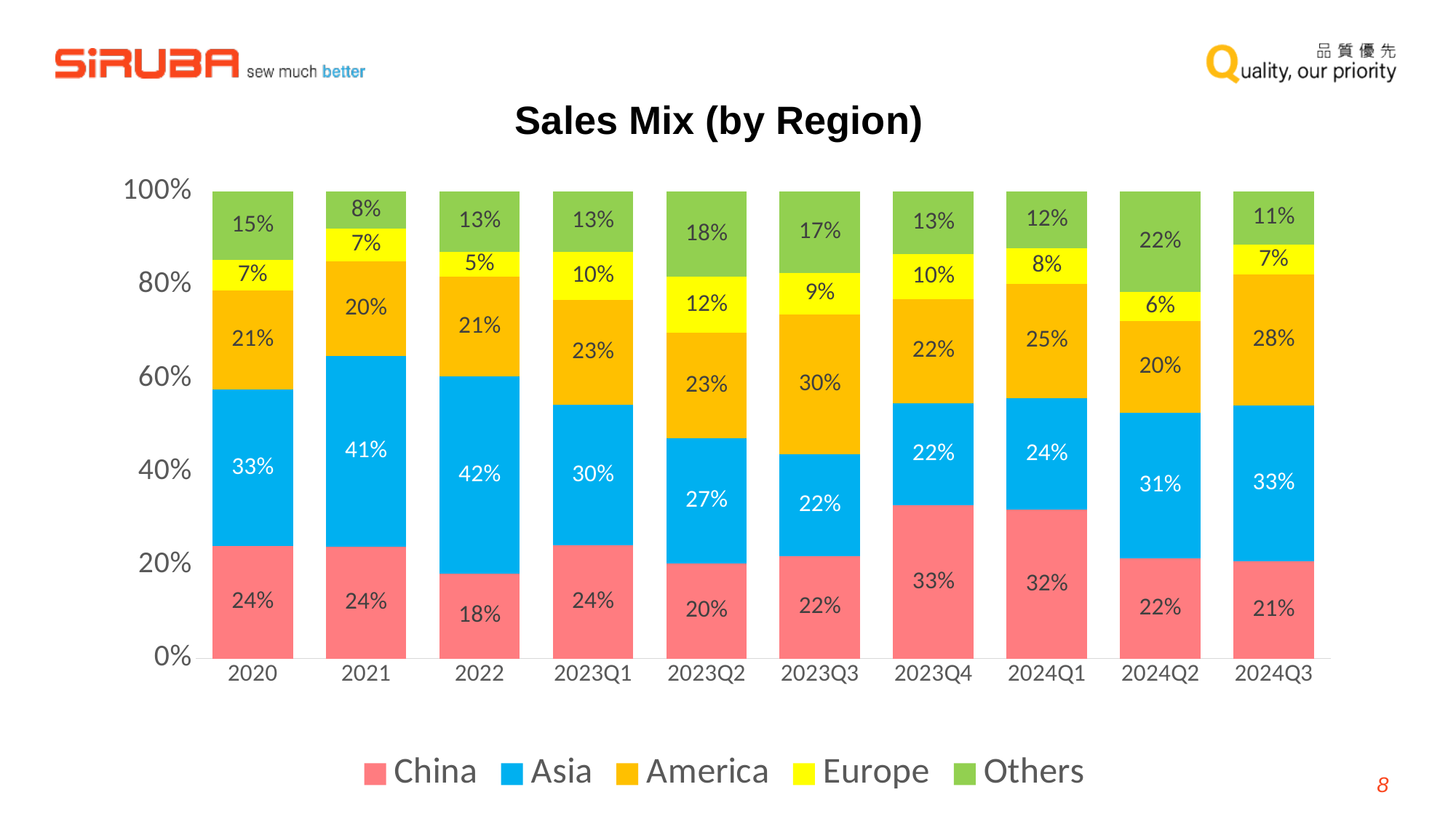
How many series does the legend list? 5 What is the America share in 2024Q3? 28% What is the China share in 2023Q4? 33% In which period is the Europe share the lowest? 2022 In which period is the Asia share the highest? 2022 What is the title of the chart? Sales Mix (by Region) What is the Europe share in 2023Q2? 12% How many periods are shown on the x axis? 10 What is the Others share in 2024Q2? 22% What is the difference between the Asia share in 2021 and the Asia share in 2023Q2? 14% What kind of chart is shown on the slide? Stacked bar chart Which is larger in 2023Q3, the America share or the Asia share? America